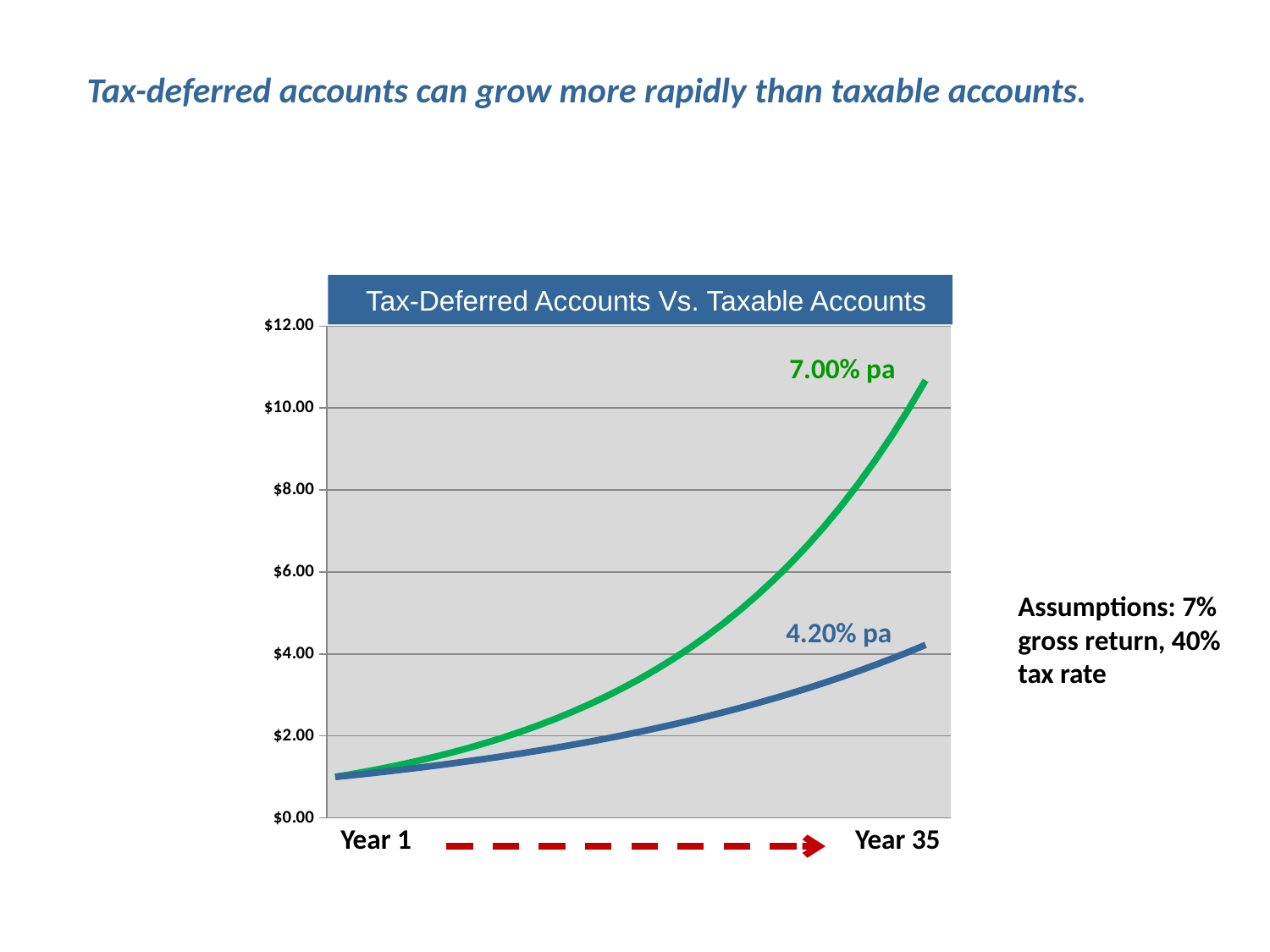
Do the values of the 4.20% pa line rise or fall from Year 1 to Year 35? Rise Is the value of the 7.00% pa line at Year 35 greater or less than $10.00? greater Which line is higher at Year 35, the 7.00% pa line or the 4.20% pa line? 7.00% pa Do the values of the 7.00% pa line rise or fall from Year 1 to Year 35? Rise How many lines (series) are plotted on the chart? 2 Which series reaches the highest value on the chart? 7.00% pa Is the value of the 4.20% pa line at Year 35 greater or less than $6.00? less Is the value of the 7.00% pa line at Year 1 greater or less than $2.00? less What colour is the 7.00% pa line? Green What is the highest value shown on the y axis of the chart? $12.00 What is the title of the chart? Tax-Deferred Accounts Vs. Taxable Accounts What kind of chart is shown on the slide? Line chart